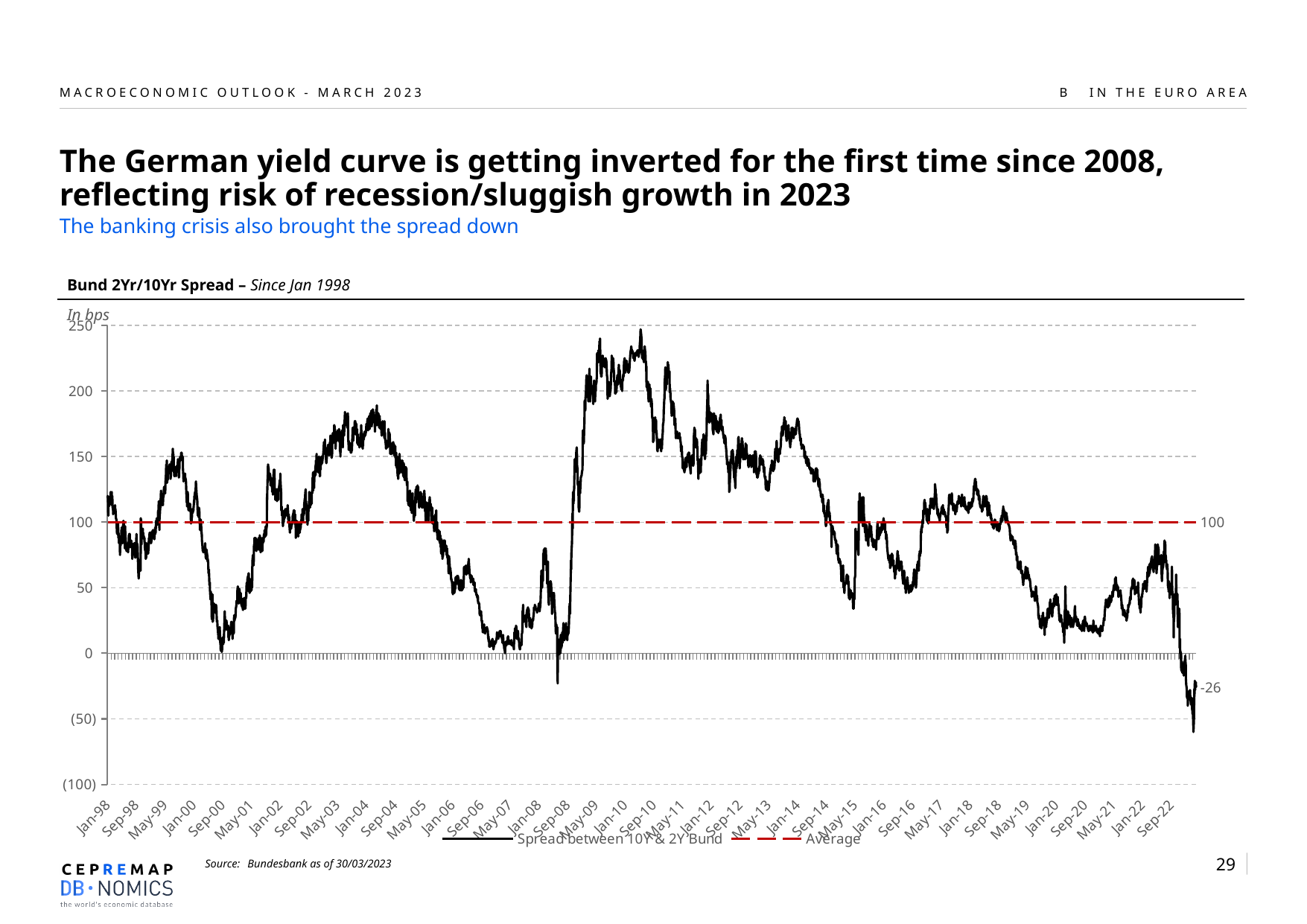
Is the spread around Jan-04 greater or less than 150? greater Is the spread around Sep-00 greater or less than 50? less Does the spread rise or fall from Jan-22 to the end of the series? fall In what unit are the values on the chart expressed? bps What kind of chart is shown on the slide? line chart Which is higher, the spread around Jan-10 or the spread around Jan-20? Jan-10 How many series does the legend list? 2 What is the title of the chart? Bund 2Yr/10Yr Spread – Since Jan 1998 Is the spread around Jan-10 greater or less than 200? greater What value is labelled for the Average line? 100 What is the latest labelled value of the spread at the right end of the line? -26 By how many bps is the latest labelled value (-26) below the Average (100)? 126